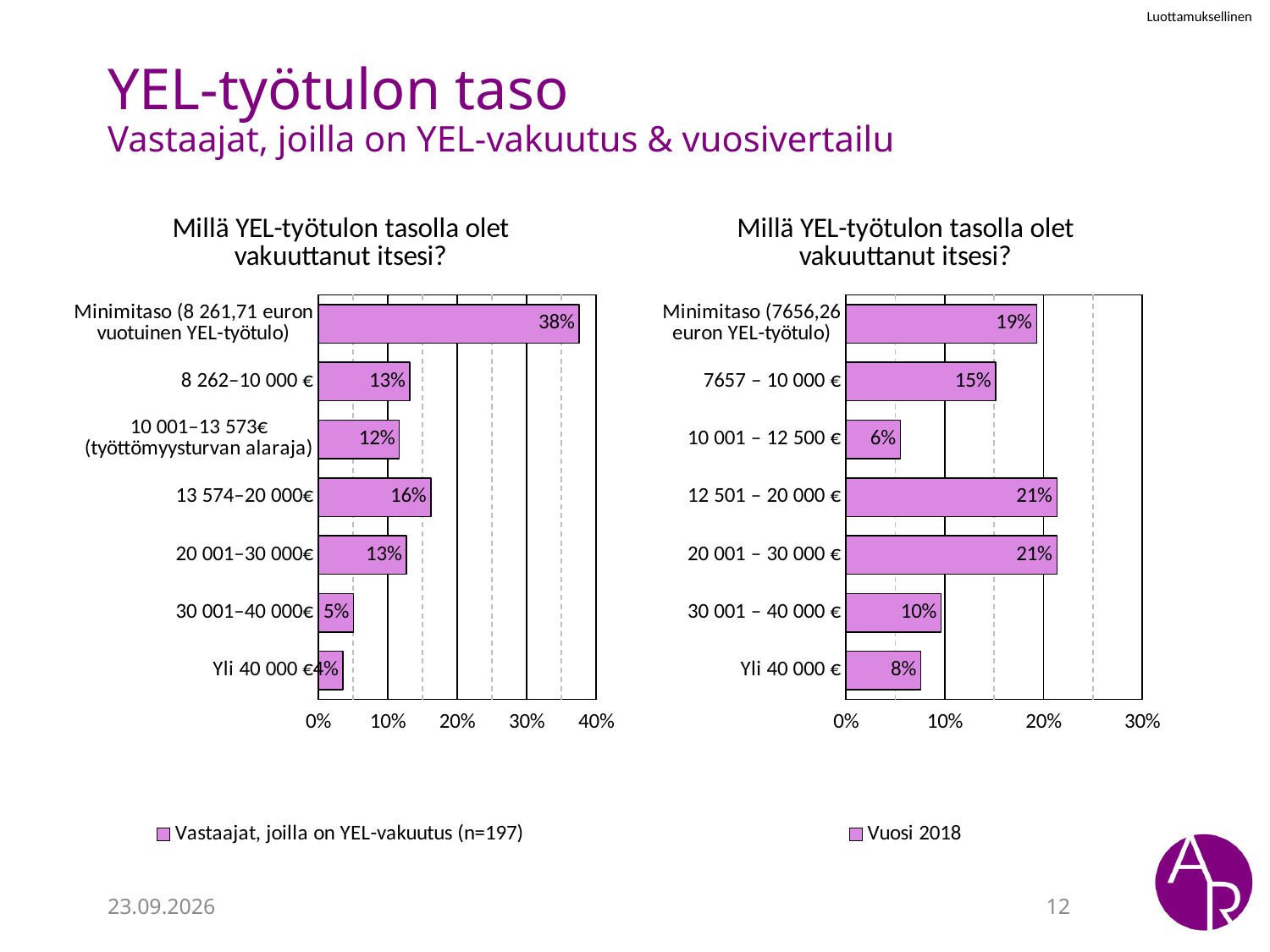
In the right chart, what is the difference between the values for '20 001 – 30 000 €' and '30 001 – 40 000 €'? 11% In the right chart, which category has the lowest value? 10 001 – 12 500 € In the right chart, what is the value for '12 501 – 20 000 €'? 21% In the left chart, what is the value for '13 574–20 000€'? 16% How many categories does the right chart show? 7 What is the legend entry for the right chart? Vuosi 2018 In the left chart, which category has the lowest value? Yli 40 000 € In the left chart, which is larger: the value for '13 574–20 000€' or the value for '10 001–13 573€ (työttömyysturvan alaraja)'? 13 574–20 000€ In the left chart, what is the value for 'Minimitaso (8 261,71 euron vuotuinen YEL-työtulo)'? 38% In the right chart, what is the value for 'Yli 40 000 €'? 8% What kind of chart is the left chart? Bar chart In the left chart, which category has the highest value? Minimitaso (8 261,71 euron vuotuinen YEL-työtulo)